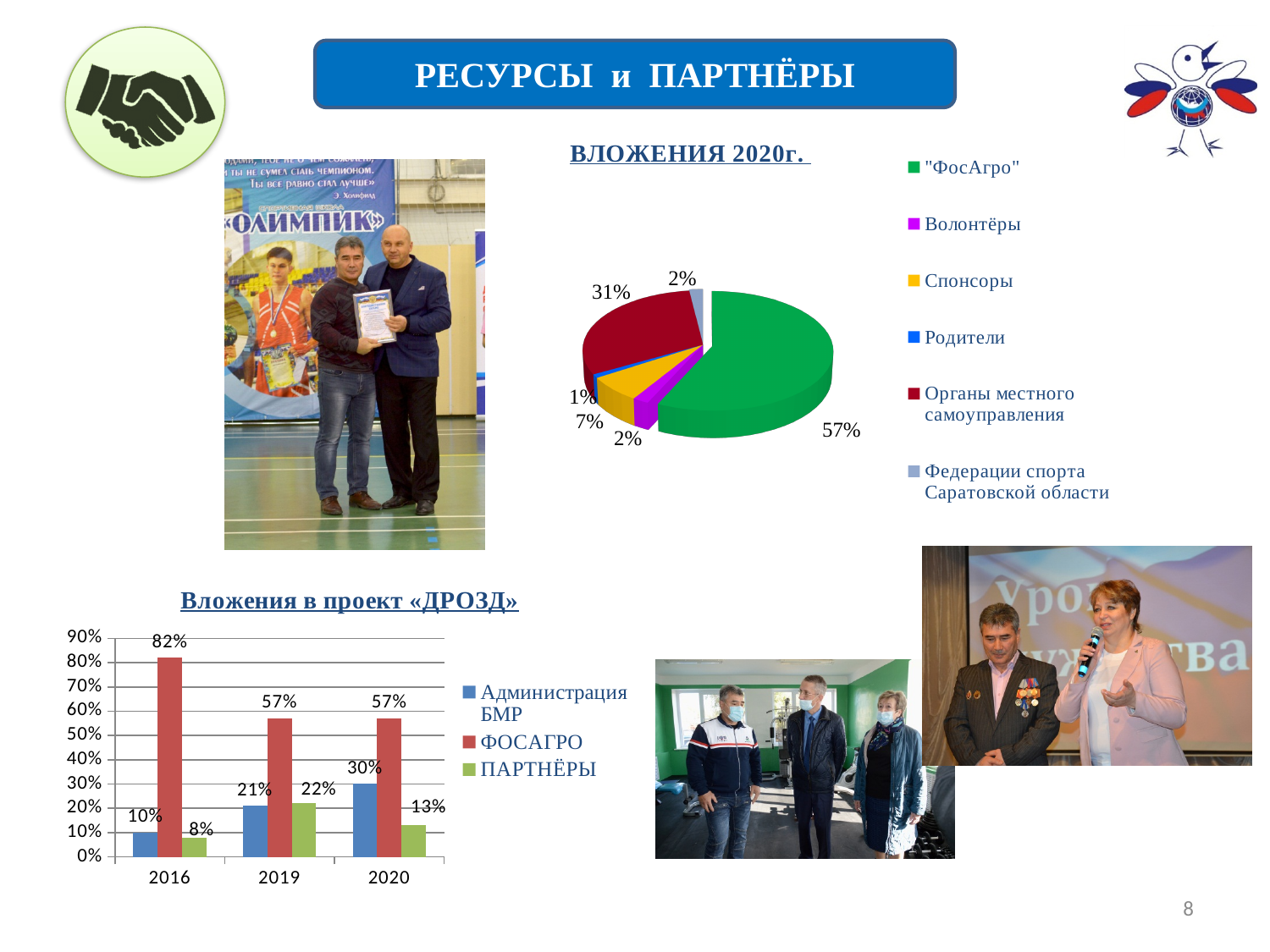
In the pie chart "ВЛОЖЕНИЯ 2020г.", how many categories does the legend list? 6 In the bar chart "Вложения в проект «ДРОЗД»", does the value for Администрация БМР rise or fall from 2016 to 2020? rise In the pie chart "ВЛОЖЕНИЯ 2020г.", what share does "ФосАгро" have? 57% In the pie chart "ВЛОЖЕНИЯ 2020г.", which category has the smallest share? Родители In the bar chart "Вложения в проект «ДРОЗД»", what is the value for ПАРТНЁРЫ in 2019? 22% In the pie chart "ВЛОЖЕНИЯ 2020г.", what share do Органы местного самоуправления have? 31% In the bar chart "Вложения в проект «ДРОЗД»", what is the difference between ФОСАГРО and Администрация БМР in 2020? 27% In the pie chart "ВЛОЖЕНИЯ 2020г.", what is the share for Спонсоры? 7% In the bar chart "Вложения в проект «ДРОЗД»", what is the value for Администрация БМР in 2020? 30% In the bar chart "Вложения в проект «ДРОЗД»", how many series does the legend list? 3 What kind of chart is "Вложения в проект «ДРОЗД»"? bar chart In the bar chart "Вложения в проект «ДРОЗД»", what is the value for ФОСАГРО in 2016? 82%